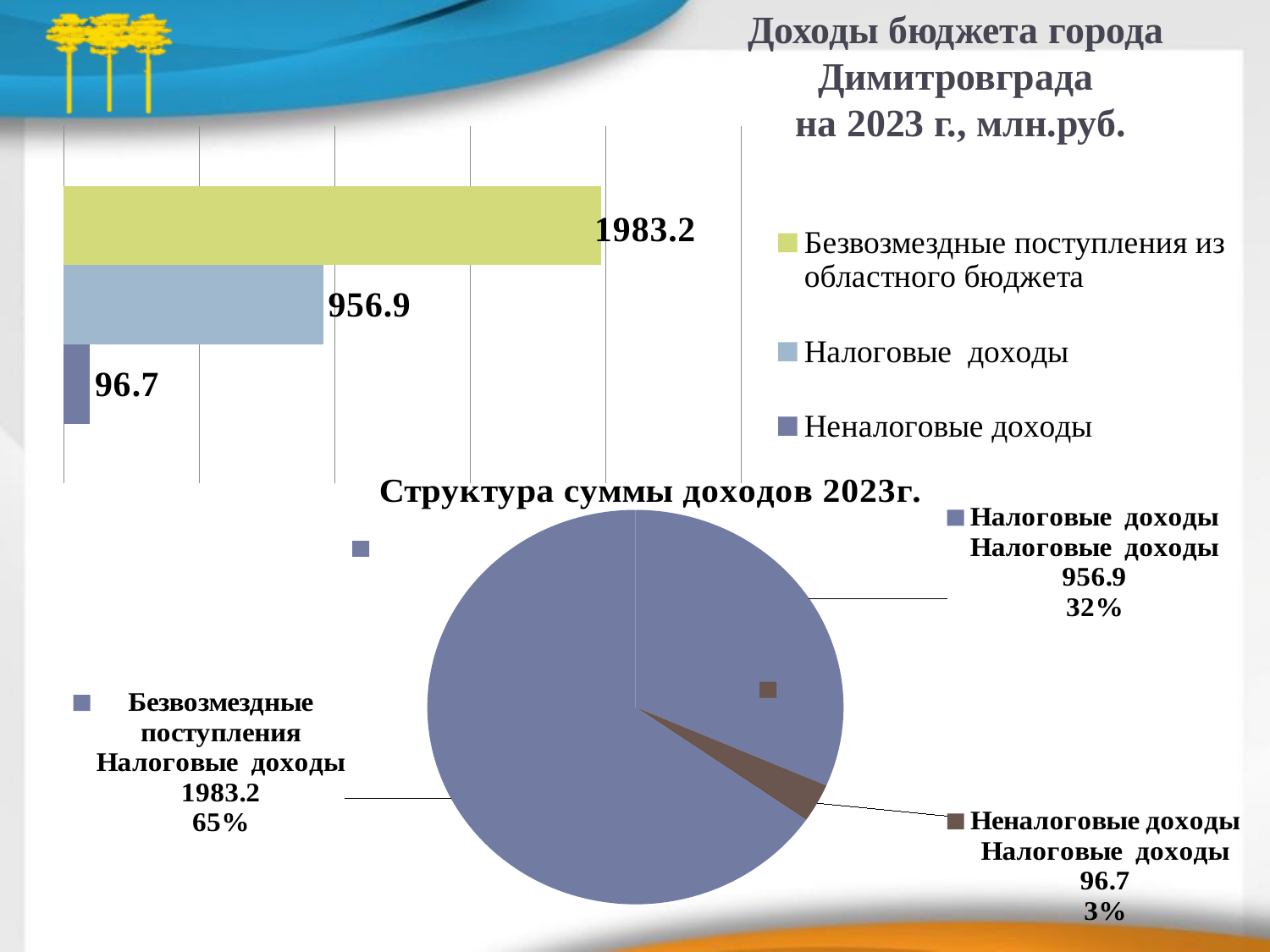
In the pie chart Структура суммы доходов 2023г., what share does Неналоговые доходы have? 3% In the top bar chart, which is larger: Налоговые доходы or Неналоговые доходы? Налоговые доходы In the top bar chart, what is the difference between Безвозмездные поступления из областного бюджета and Налоговые доходы? 1026.3 In the top bar chart, what is the value for Безвозмездные поступления из областного бюджета? 1983.2 In the pie chart Структура суммы доходов 2023г., what share does Налоговые доходы have? 32% What type of chart is the top chart on the slide? bar chart In the top bar chart, what is the value for Неналоговые доходы? 96.7 How many entries does the legend of the top bar chart list? 3 In the top bar chart, which category has the lowest value? Неналоговые доходы How many slices does the pie chart Структура суммы доходов 2023г. have? 3 In the top bar chart, which category has the highest value? Безвозмездные поступления из областного бюджета In the top bar chart, what is the value for Налоговые доходы? 956.9